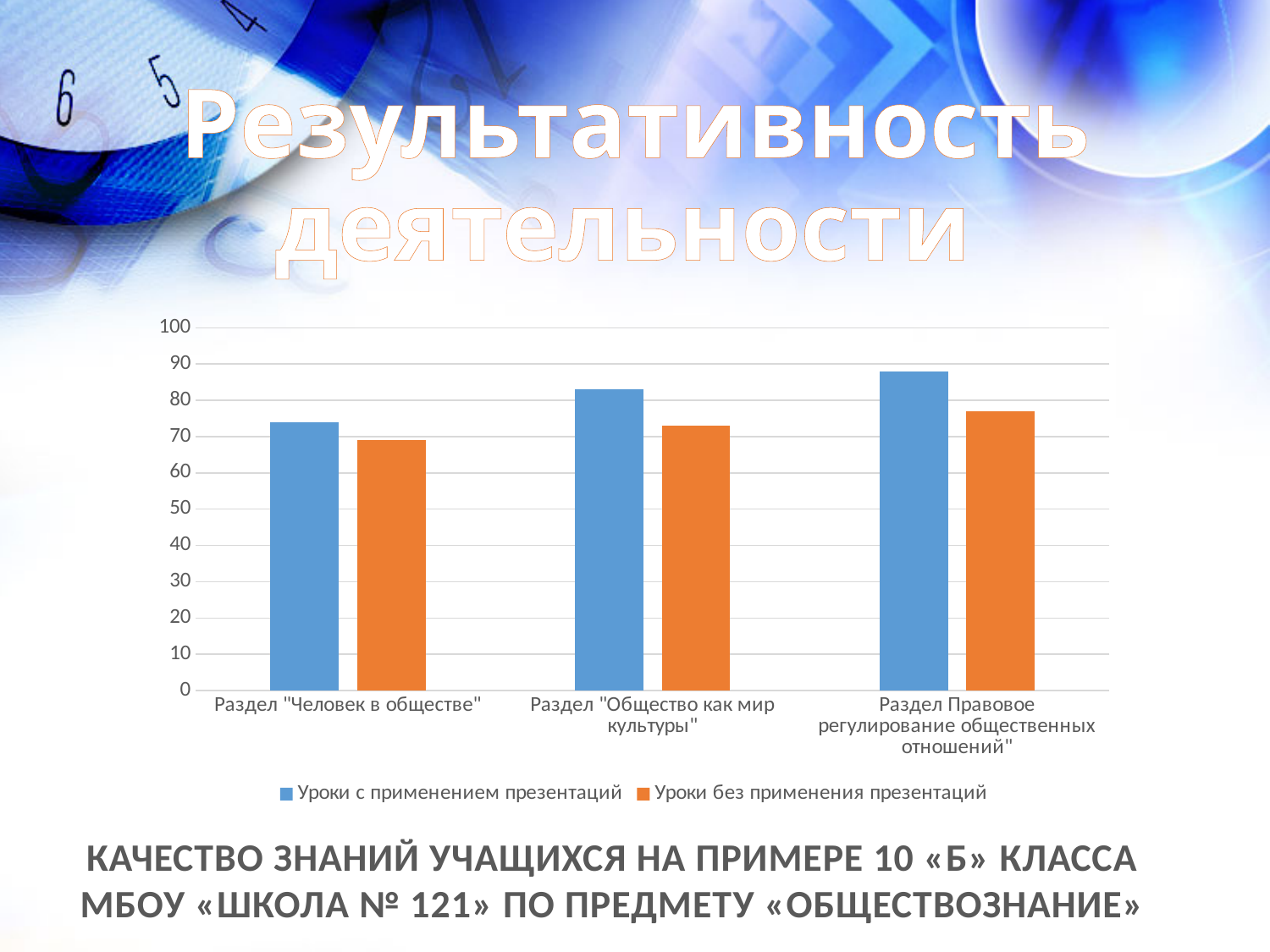
In the section "Человек в обществе", which series has the larger value: "Уроки с применением презентаций" or "Уроки без применения презентаций"? Уроки с применением презентаций For the series "Уроки с применением презентаций", which section has the lowest value? Раздел "Человек в обществе" For the series "Уроки без применения презентаций", which section has the highest value? Раздел Правовое регулирование общественных отношений" Is the value for "Уроки с применением презентаций" in the section "Правовое регулирование общественных отношений" greater or less than 80? greater How many categories (sections) are shown on the x axis of the chart? 3 Is the value for "Уроки без применения презентаций" in the section "Человек в обществе" greater or less than 60? greater How many series does the chart's legend list? 2 For the series "Уроки без применения презентаций", which section has the lowest value? Раздел "Человек в обществе" What colour represents the series "Уроки без применения презентаций" in the chart? orange What kind of chart is shown on the slide? bar chart For the series "Уроки с применением презентаций", which section has the highest value? Раздел Правовое регулирование общественных отношений" Do the values for "Уроки с применением презентаций" rise or fall from left to right across the sections? rise